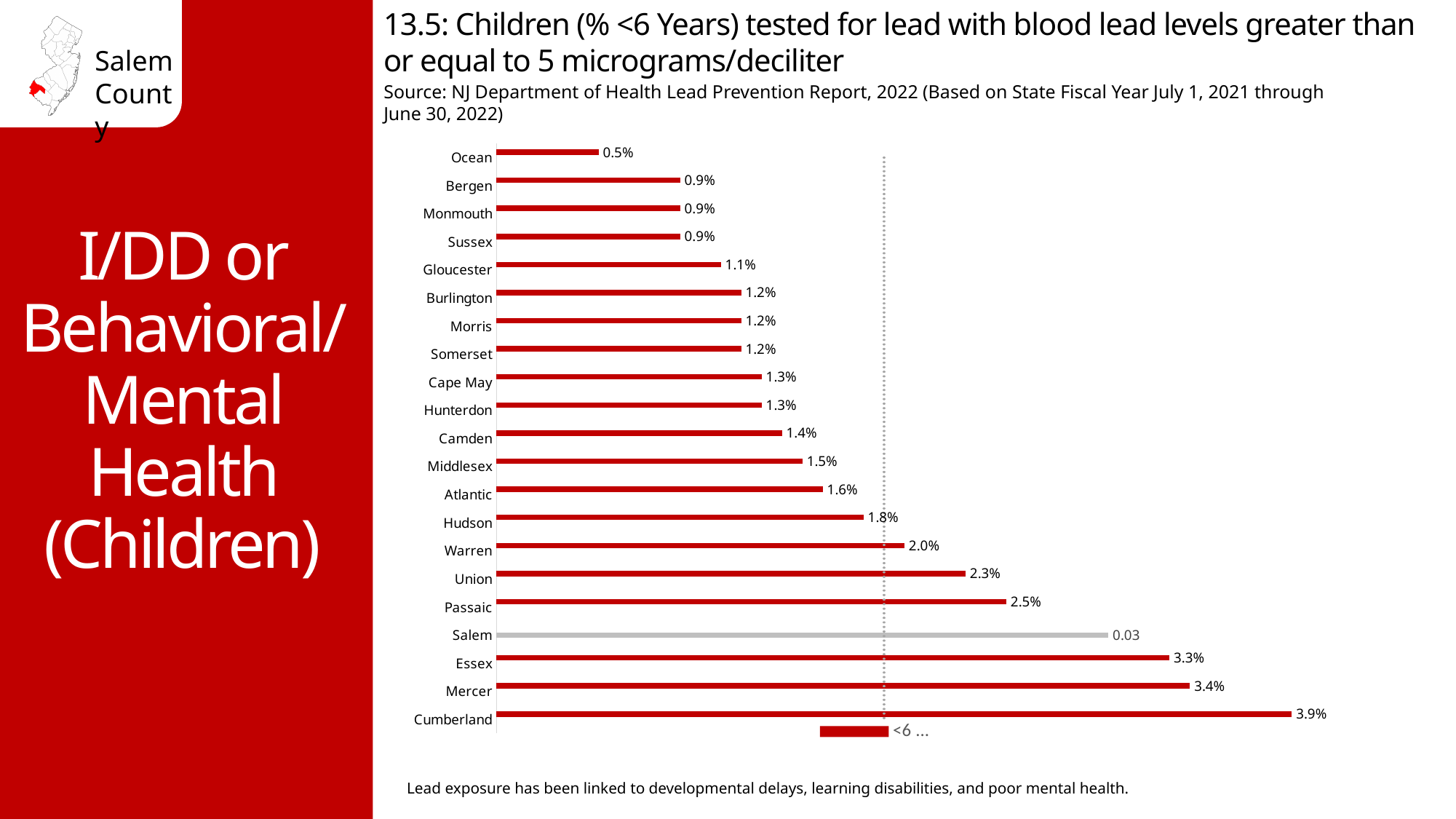
Which county has the highest value? Cumberland What is the value for Hudson? 1.8% What value is labeled on the Salem bar? 0.03 What is the value for Passaic? 2.5% What kind of chart is shown? bar chart How many counties are shown in the chart? 21 Which county has the lowest value? Ocean What is the difference between the values for Cumberland and Ocean? 3.4% Which has a larger value, Essex or Mercer? Mercer What colour is the Salem bar, unlike the other bars? gray What is the value for Cumberland? 3.9% What is the difference between the values for Union and Warren? 0.3%